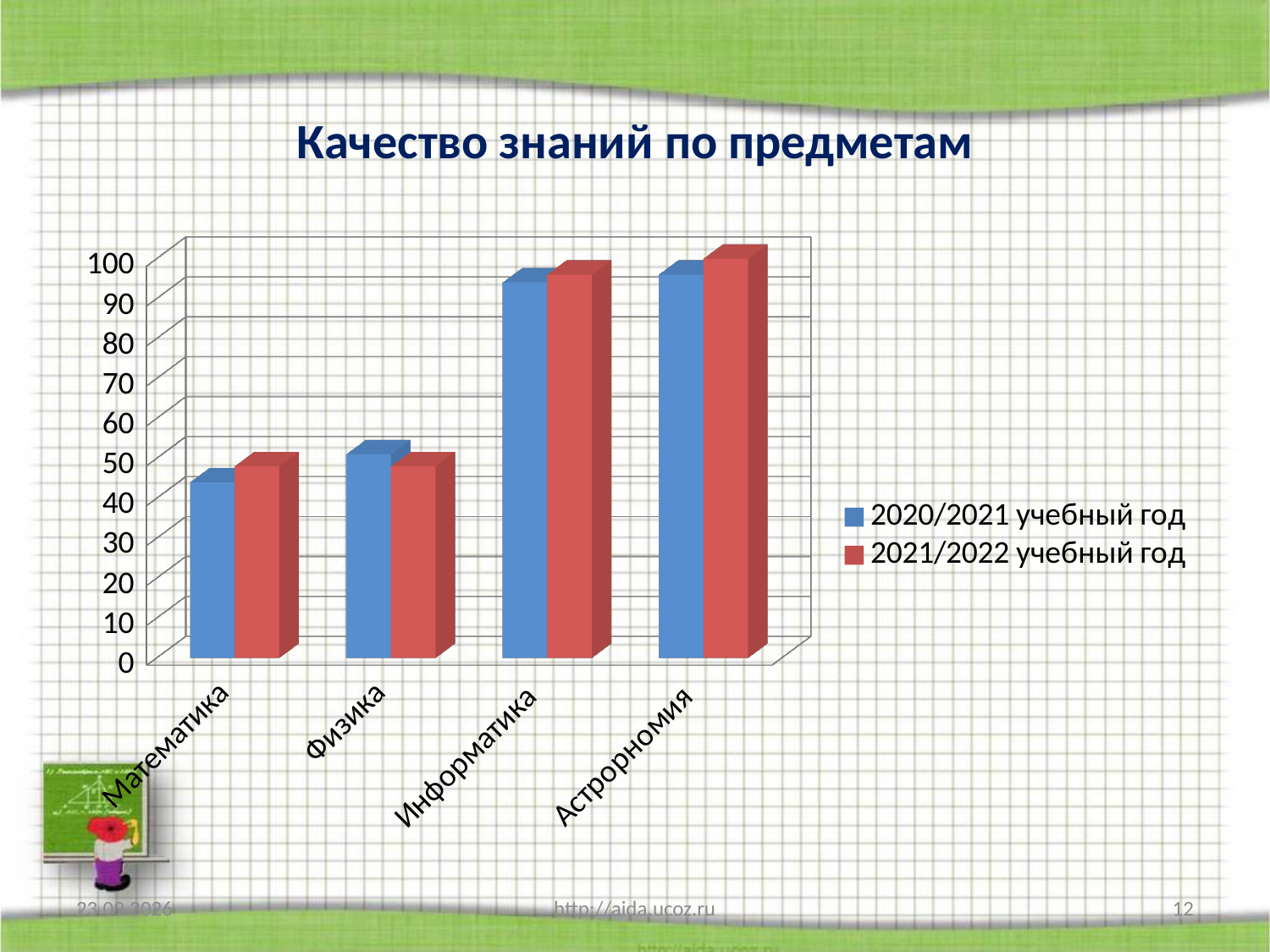
What is the title of the chart? Качество знаний по предметам Is the value for Астрорномия in 2021/2022 учебный год greater or less than 90? greater How many subject categories are shown on the x axis? 4 Which subject has the lowest value in the 2020/2021 учебный год series? Математика Which subject has the highest value in the 2021/2022 учебный год series? Астрорномия For Информатика, which is larger: the 2021/2022 учебный год value or the Математика 2021/2022 учебный год value? Информатика Is the value for Математика in 2020/2021 учебный год greater or less than 50? less Which colour represents the 2021/2022 учебный год series? red How many series does the legend list? 2 What kind of chart is shown on the slide? bar chart Is the value for Информатика in 2020/2021 учебный год greater or less than 90? greater